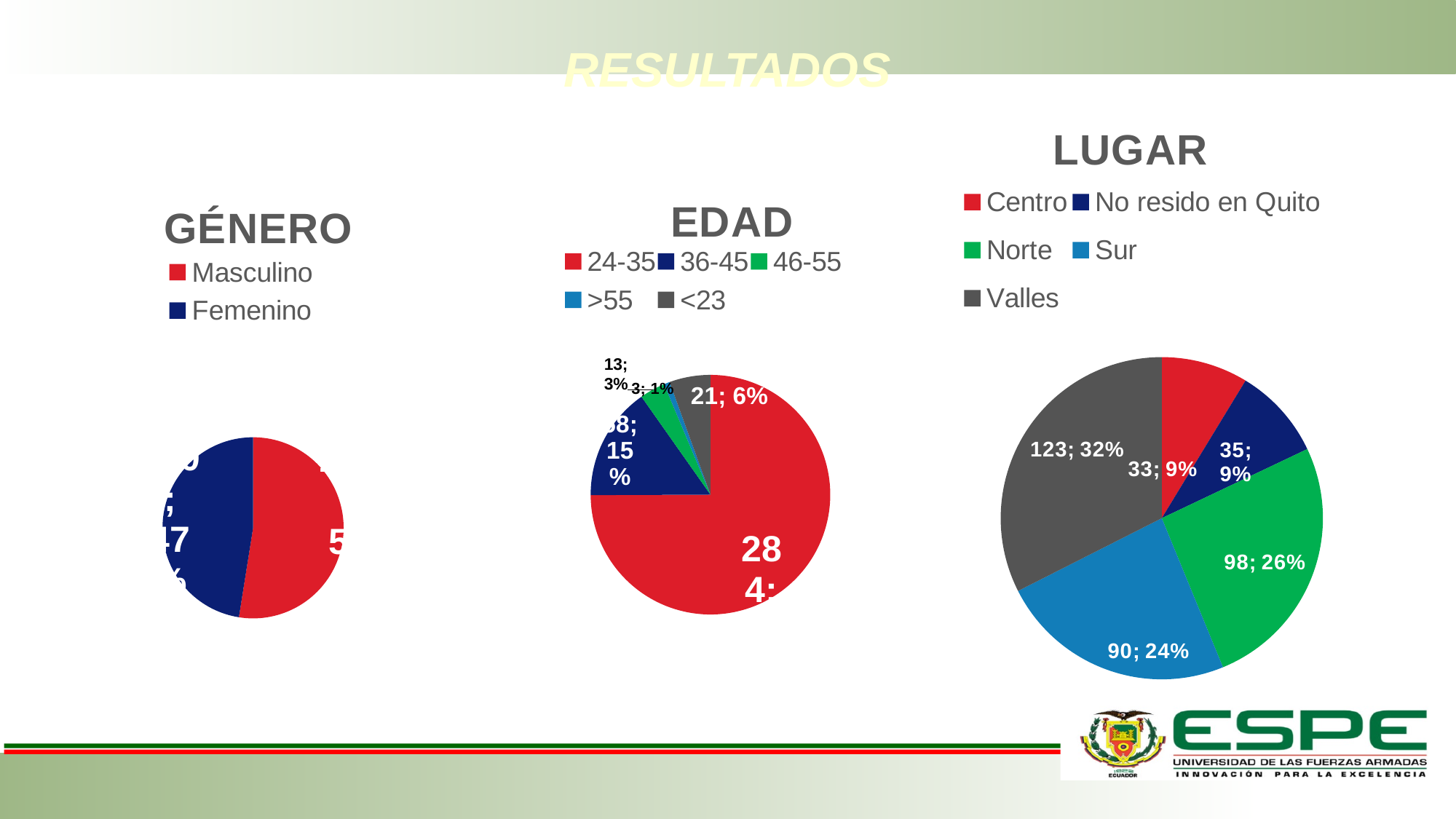
In the LUGAR chart, what percentage share does No resido en Quito have? 9% In the LUGAR chart, what is the value for Sur? 90; 24% In the LUGAR chart, which is larger, Norte or Sur? Norte In the EDAD chart, which age group has the smallest slice? >55 In the LUGAR chart, what is the difference between the counts for Valles and Norte? 25 In the LUGAR chart, what is the value for Valles? 123; 32% In the LUGAR chart, what is the value for Norte? 98; 26% How many categories does the legend of the GÉNERO chart list? 2 In the LUGAR chart, which category has the largest slice? Valles How many categories does the legend of the LUGAR chart list? 5 What kind of chart is the LUGAR chart? pie chart In the EDAD chart, what is the value for the <23 slice? 21; 6%